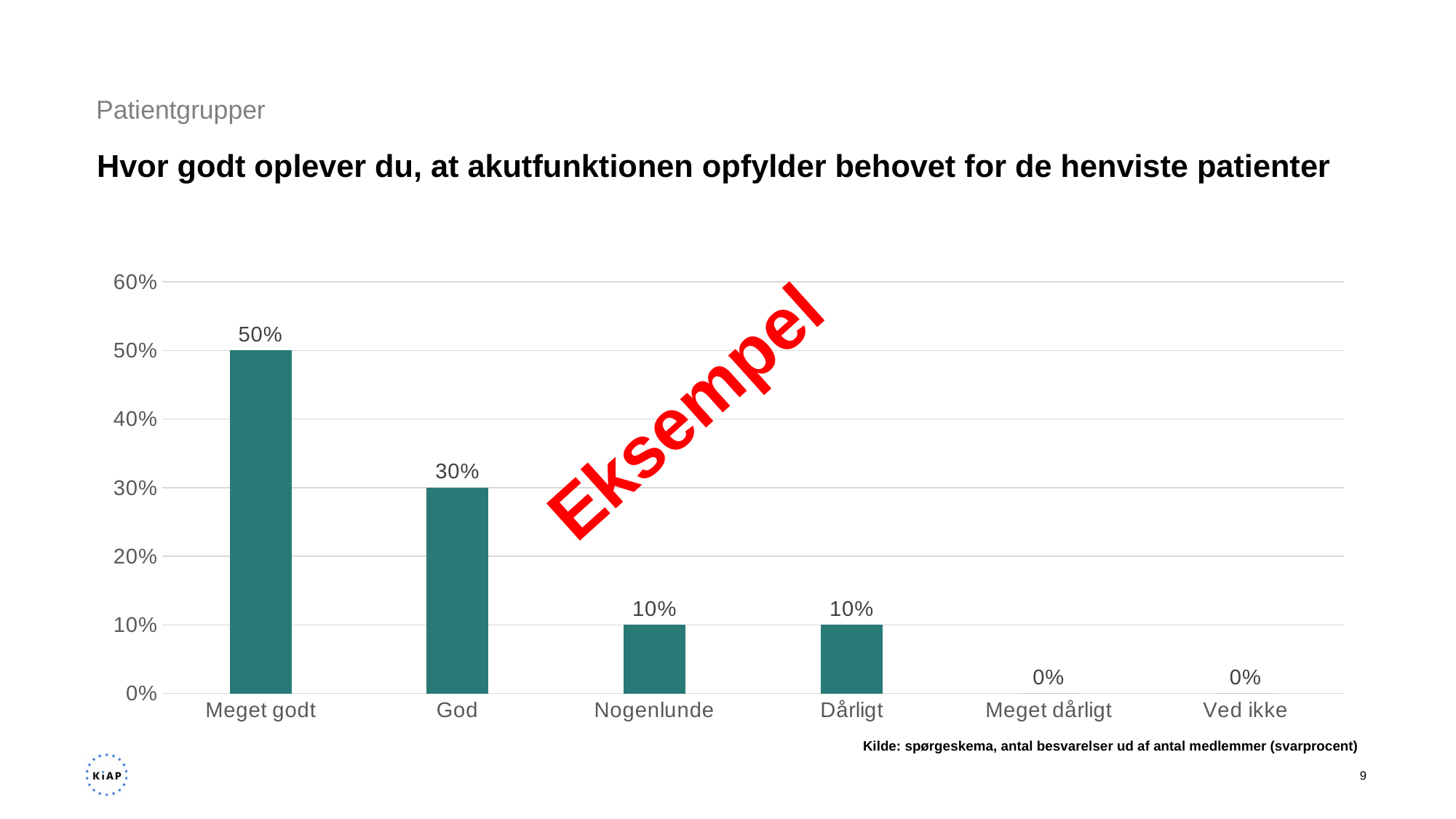
How many categories are shown on the x axis? 6 Do the values rise or fall from "Meget godt" to "Ved ikke" along the x axis? Fall What kind of chart is shown on the slide? Bar chart What is the difference between the values for "Meget godt" and "God"? 20% Which is larger, the value for "God" or the value for "Dårligt"? God What is the value for "Meget dårligt"? 0% What is the value for "Nogenlunde"? 10% What is the value for "Meget godt"? 50% What is the value for "God"? 30% Which category has the highest value? Meget godt What is the title of the chart? Hvor godt oplever du, at akutfunktionen opfylder behovet for de henviste patienter Is the value for "God" greater or less than 40%? less